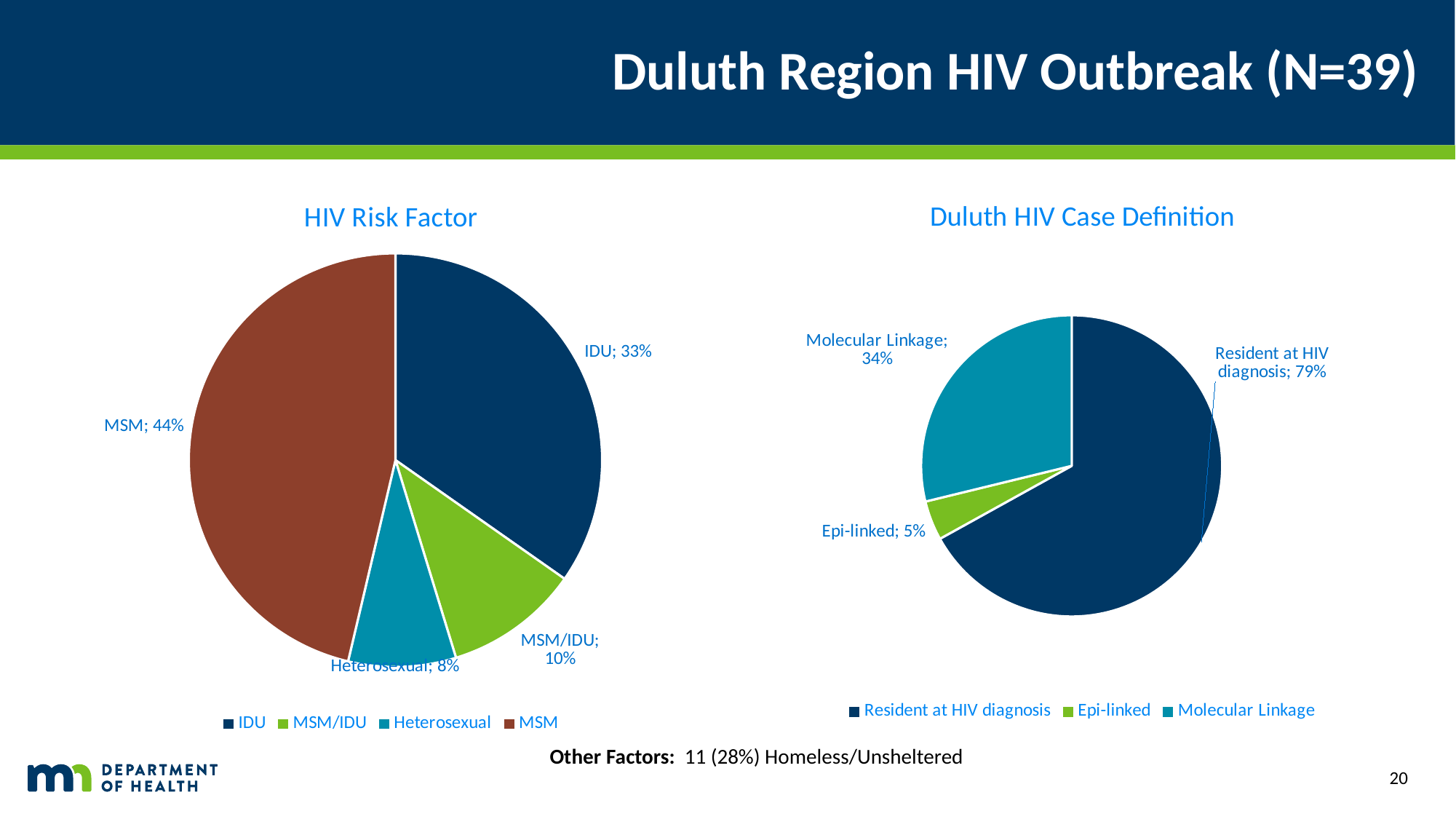
In the HIV Risk Factor chart, how many categories are shown? 4 What kind of chart is the HIV Risk Factor chart? Pie chart In the HIV Risk Factor chart, what share of the pie is MSM? 44% In the Duluth HIV Case Definition chart, what is the value for Molecular Linkage? 34% In the HIV Risk Factor chart, which risk factor has the smallest slice? Heterosexual In the HIV Risk Factor chart, what is the value for IDU? 33% In the HIV Risk Factor chart, what is the difference between the MSM and IDU percentages? 11% In the Duluth HIV Case Definition chart, how many entries does the legend list? 3 In the Duluth HIV Case Definition chart, which category has the smallest slice? Epi-linked In the Duluth HIV Case Definition chart, which is larger, Resident at HIV diagnosis or Molecular Linkage? Resident at HIV diagnosis In the HIV Risk Factor chart, what colour is the MSM/IDU slice? Green In the HIV Risk Factor chart, which risk factor has the largest slice? MSM